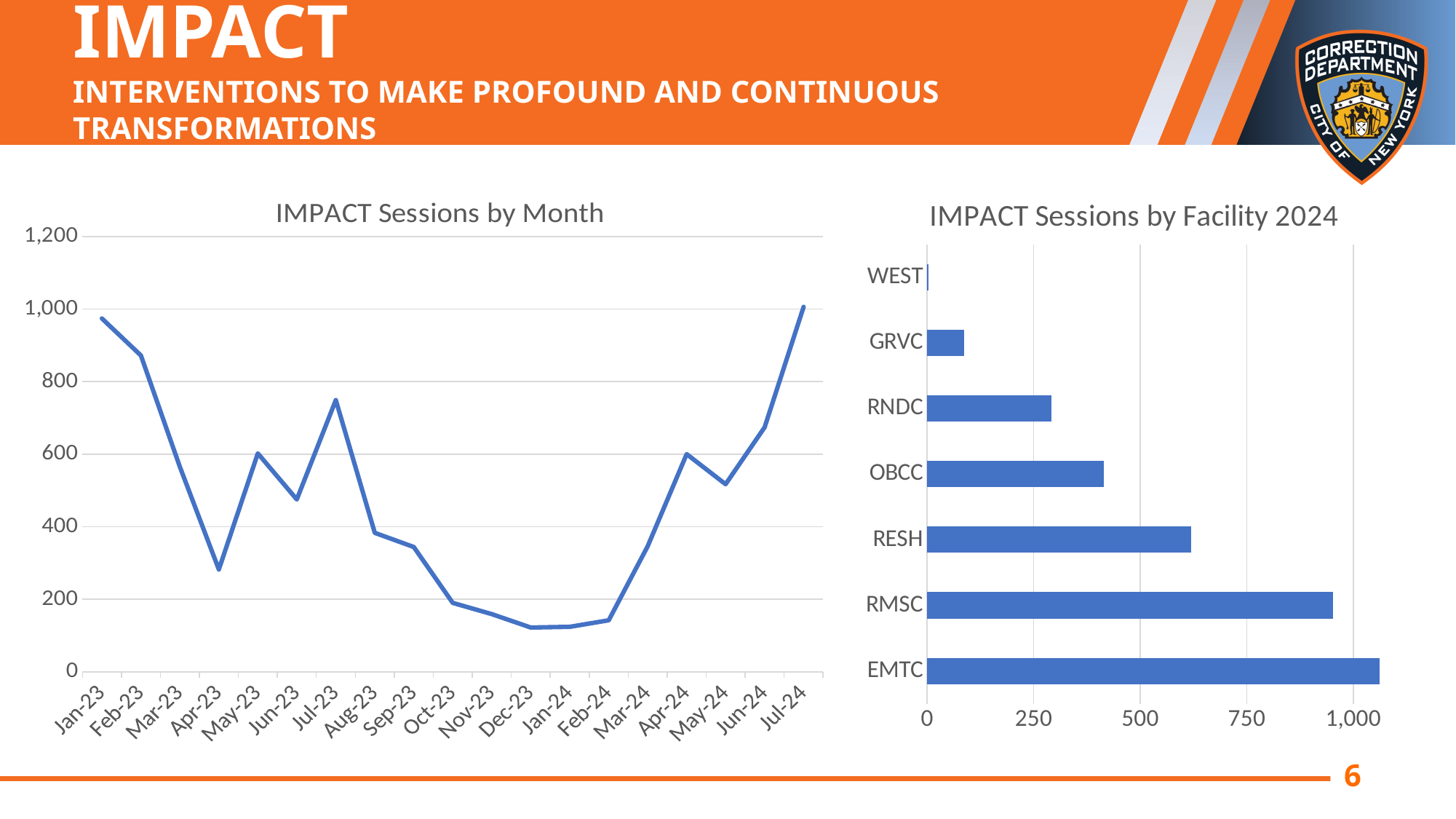
In "IMPACT Sessions by Facility 2024", is the value for RMSC greater or less than 750? greater In "IMPACT Sessions by Month", do the values rise or fall from Feb-24 to Jul-24? rise In "IMPACT Sessions by Facility 2024", which facility has the highest number of sessions? EMTC How many months are plotted in "IMPACT Sessions by Month"? 19 In "IMPACT Sessions by Facility 2024", is the value for GRVC greater or less than 250? less In "IMPACT Sessions by Facility 2024", which facility has the lowest number of sessions? WEST In "IMPACT Sessions by Facility 2024", is the value for OBCC greater or less than 500? less What kind of chart is "IMPACT Sessions by Facility 2024"? bar chart How many facilities are shown in "IMPACT Sessions by Facility 2024"? 7 What kind of chart is "IMPACT Sessions by Month"? line chart In "IMPACT Sessions by Month", which is larger, the value for Jul-23 or the value for Aug-23? Jul-23